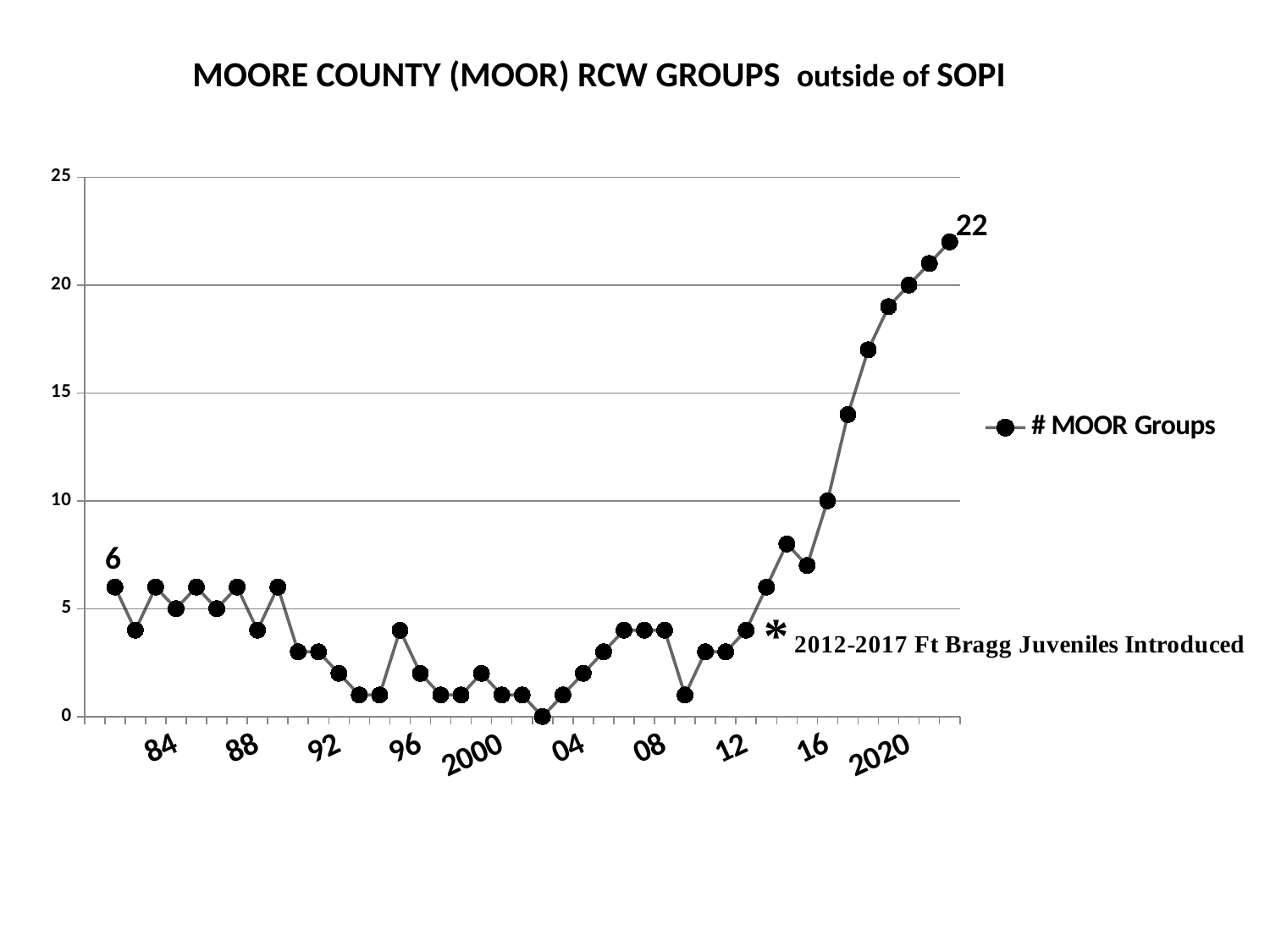
What is the difference between the last labeled value (22) and the first labeled value (6)? 16 Which year has the larger number of MOOR groups, 1984 or 2020? 2020 What is the value labeled at the first point of the line? 6 How many series does the legend list? 1 Is the value for 2020 greater or less than 15? greater What kind of chart is shown on the slide? line chart Do the values rise or fall from 2012 to 2020? rise What is the lowest value of # MOOR Groups shown on the chart? 0 What is the highest value of # MOOR Groups shown on the chart? 22 What is the value labeled at the last point of the line? 22 Is the value for 2000 greater or less than 5? less What is the name of the series in the legend? # MOOR Groups